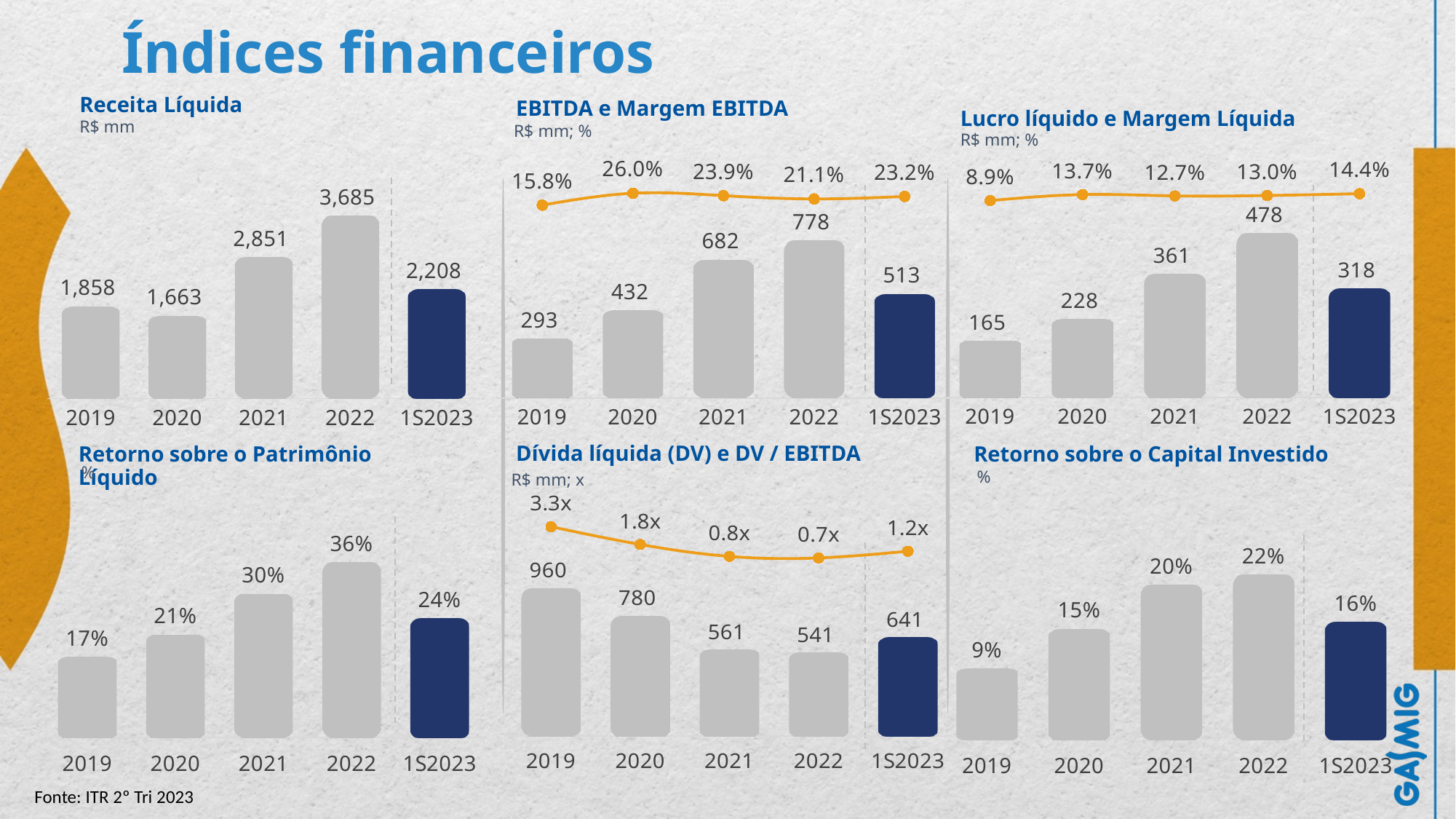
In the 'Retorno sobre o Patrimônio Líquido' chart, what is the value for 2021? 30% In the 'Dívida líquida (DV) e DV / EBITDA' chart, which is larger, the net debt bar for 2020 or for 1S2023? 2020 In the 'Retorno sobre o Capital Investido' chart, what is the difference between the 2022 and 2019 values? 13% In the 'Lucro líquido e Margem Líquida' chart, what is the net income bar value for 1S2023? 318 In the 'EBITDA e Margem EBITDA' chart, what is the EBITDA margin for 2020? 26.0% In the 'Receita Líquida' chart, what is the value for 2022? 3,685 In the 'Retorno sobre o Patrimônio Líquido' chart, do the values rise or fall from 2019 to 2022? rise In the 'Lucro líquido e Margem Líquida' chart, which period has the highest net margin on the line? 1S2023 In the 'Dívida líquida (DV) e DV / EBITDA' chart, what is the DV / EBITDA value for 2019? 3.3x In the 'Receita Líquida' chart, which year has the lowest value? 2020 In the 'EBITDA e Margem EBITDA' chart, what is the difference between the EBITDA bars for 2022 and 2021? 96 In the 'Retorno sobre o Capital Investido' chart, how many periods are shown on the x axis? 5